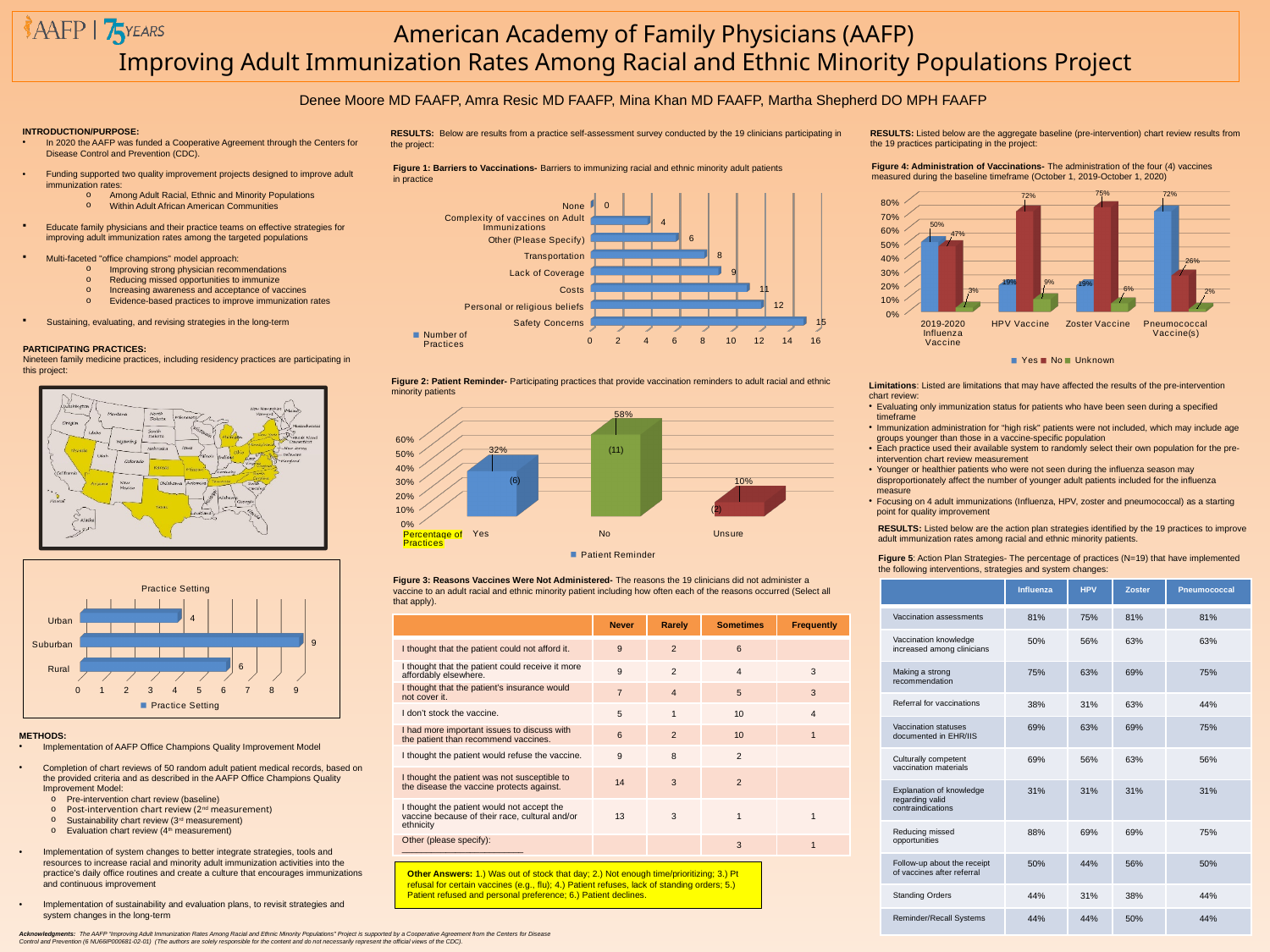
In Figure 2: Patient Reminder, which response has the lowest percentage? Unsure In Figure 1: Barriers to Vaccinations, what is the value for Transportation? 8 In Figure 1: Barriers to Vaccinations, how many barrier categories are plotted? 8 In Figure 4: Administration of Vaccinations, what is the Yes percentage for Pneumococcal Vaccine(s)? 72% In the Practice Setting chart, which practice setting has the lowest value? Urban In Figure 2: Patient Reminder, what percentage of practices answered No? 58% In Figure 1: Barriers to Vaccinations, how many practices reported Safety Concerns? 15 In Figure 1: Barriers to Vaccinations, which barrier has the highest number of practices? Safety Concerns In Figure 4: Administration of Vaccinations, how many series does the legend list? 3 In Figure 4: Administration of Vaccinations, which is larger for the HPV Vaccine, Yes or No? No In the Practice Setting chart, what is the difference between the Suburban and Rural values? 3 In the Practice Setting chart, what is the value for Suburban? 9